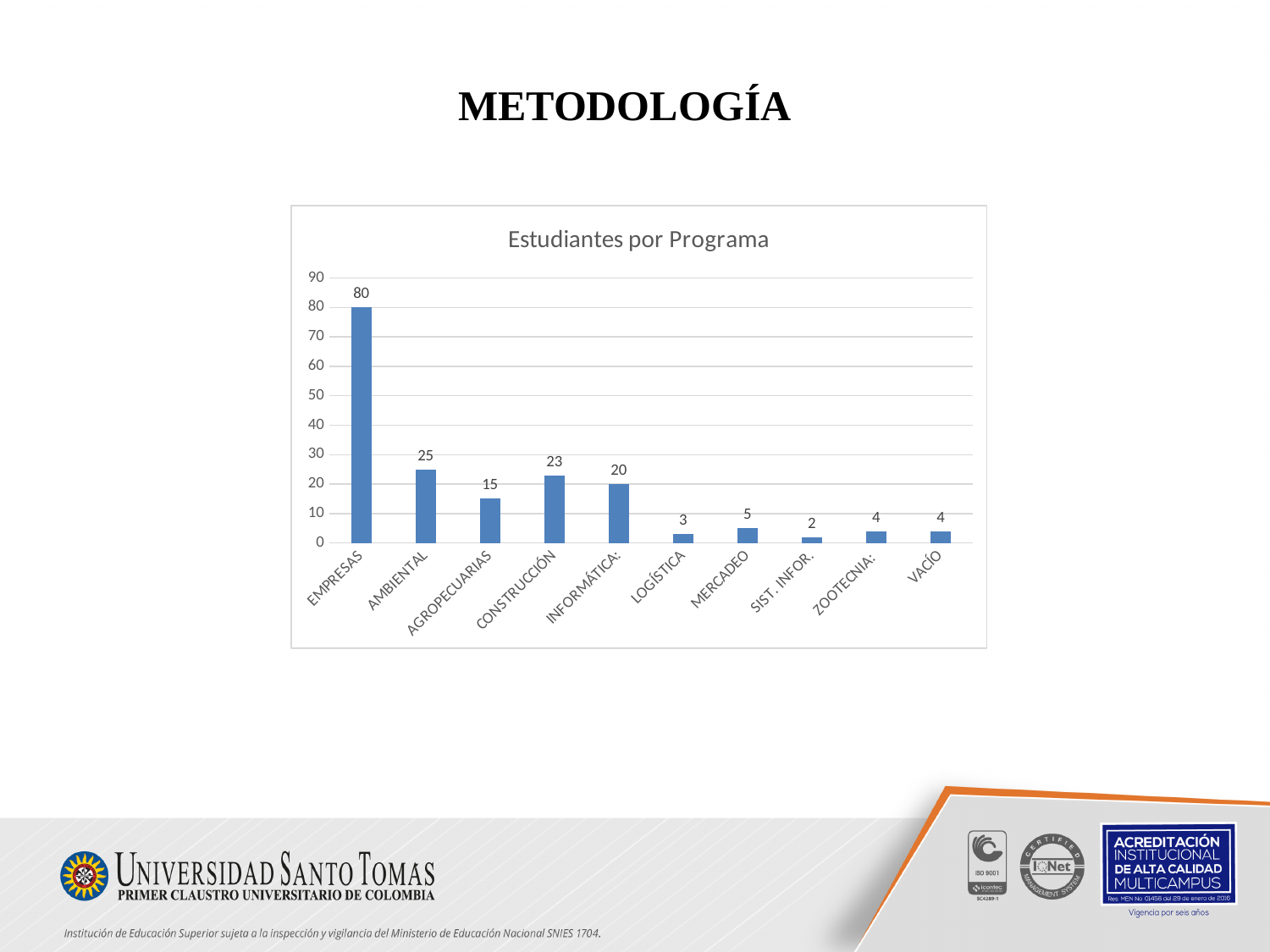
What is the difference between the values for CONSTRUCCIÓN and INFORMÁTICA? 3 Which category has the highest value? EMPRESAS How many categories are shown on the x axis? 10 What is the difference between the values for EMPRESAS and AMBIENTAL? 55 Is the value for INFORMÁTICA greater or less than 30? less Which category has the lowest value? SIST. INFOR. What is the title of the chart? Estudiantes por Programa What is the value for AGROPECUARIAS? 15 What is the value for EMPRESAS in the Estudiantes por Programa chart? 80 Which is larger, the value for MERCADEO or the value for LOGÍSTICA? MERCADEO What is the value for CONSTRUCCIÓN? 23 What kind of chart is shown on the slide? Bar chart